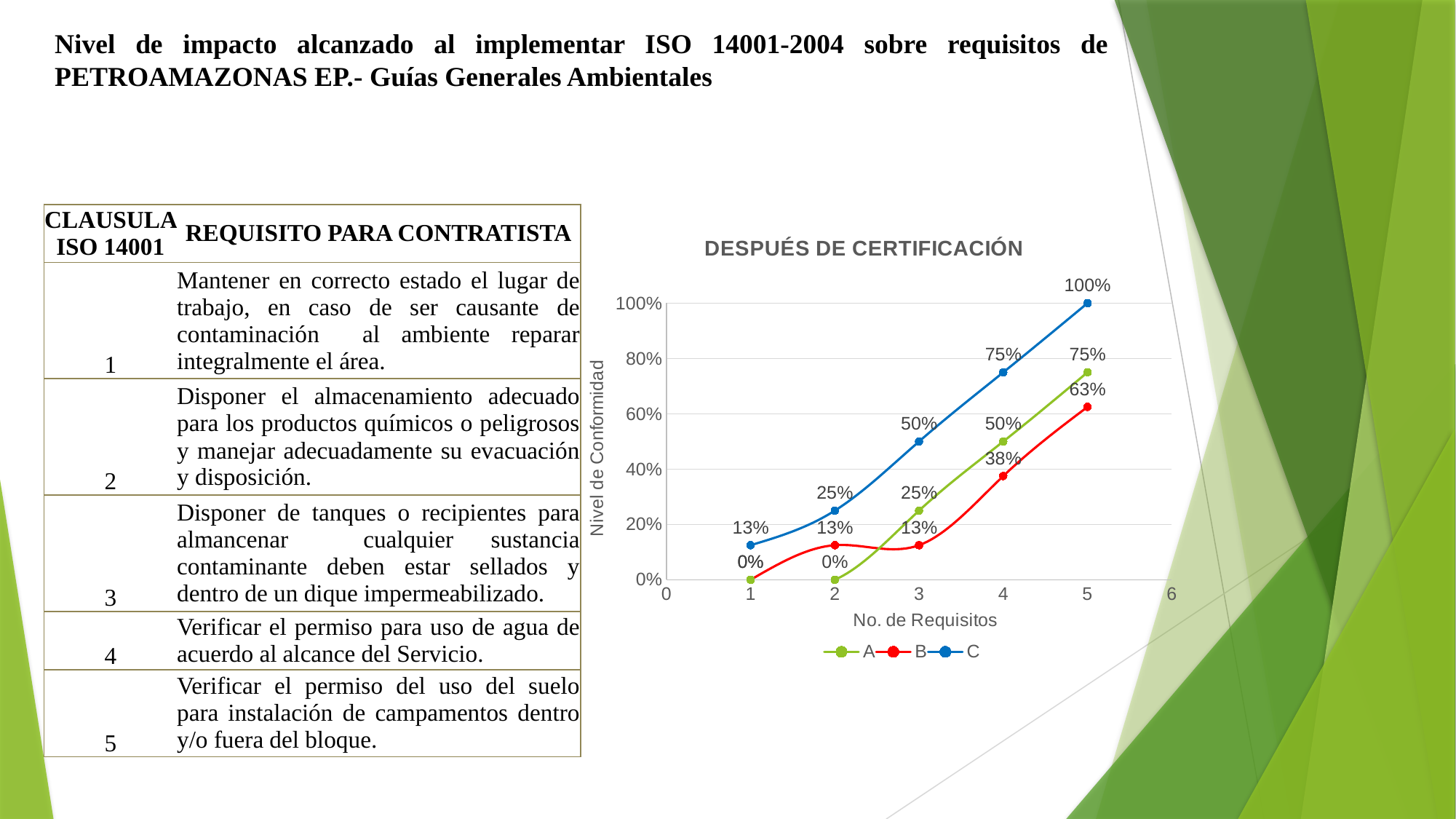
What type of chart is shown on the slide? line chart Which is larger at requisito 3: series B or series C? C What is the value of series B at requisito 5? 63% Which series has the lowest value at requisito 2? A What is the value of series C at requisito 5? 100% What is the value of series B at requisito 4? 38% Which series has the highest value at requisito 4? C What is the title of the chart? DESPUÉS DE CERTIFICACIÓN What is the difference between series C and series A at requisito 5? 25% How many series does the chart legend list? 3 Does series C rise or fall as the number of requisitos increases from 1 to 5? rise What is the value of series A at requisito 3? 25%